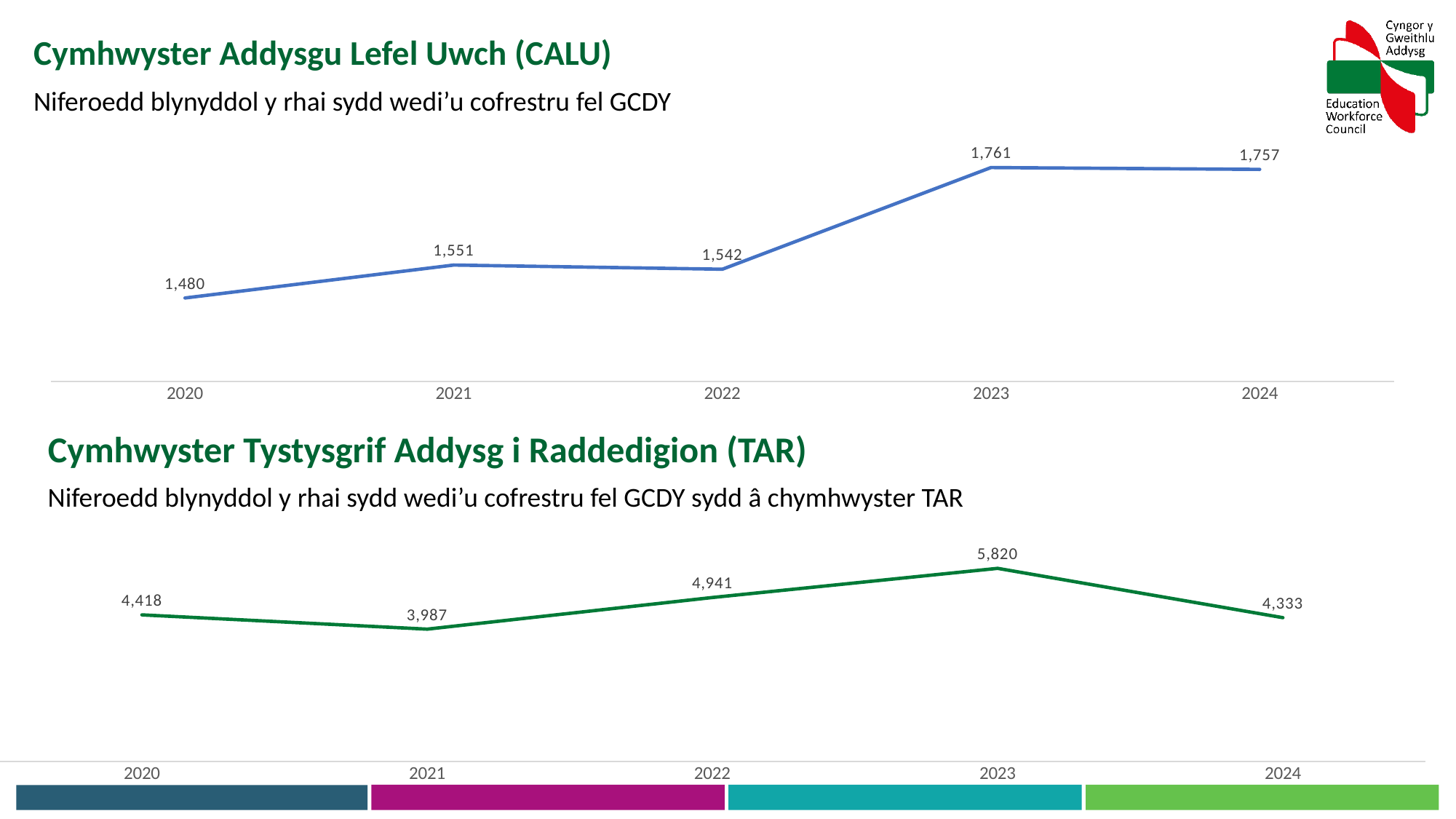
What type of chart is the top chart (CALU)? Line chart In the top chart (CALU), which year has the highest value? 2023 In the bottom chart (Cymhwyster Tystysgrif Addysg i Raddedigion (TAR)), what is the value for 2022? 4,941 In the top chart (Cymhwyster Addysgu Lefel Uwch (CALU)), what is the value for 2020? 1,480 In the top chart (CALU), what is the difference between the 2023 value and the 2020 value? 281 In the top chart (CALU), which year has the lowest value? 2020 In the bottom chart (TAR), is the value for 2020 or 2024 larger? 2020 In the bottom chart (TAR), what is the difference between the 2023 value and the 2024 value? 1,487 In the bottom chart (TAR), which year has the highest value? 2023 In the top chart (CALU), what is the value for 2023? 1,761 In the top chart (CALU), how many years are plotted? 5 In the bottom chart (TAR), which year has the lowest value? 2021